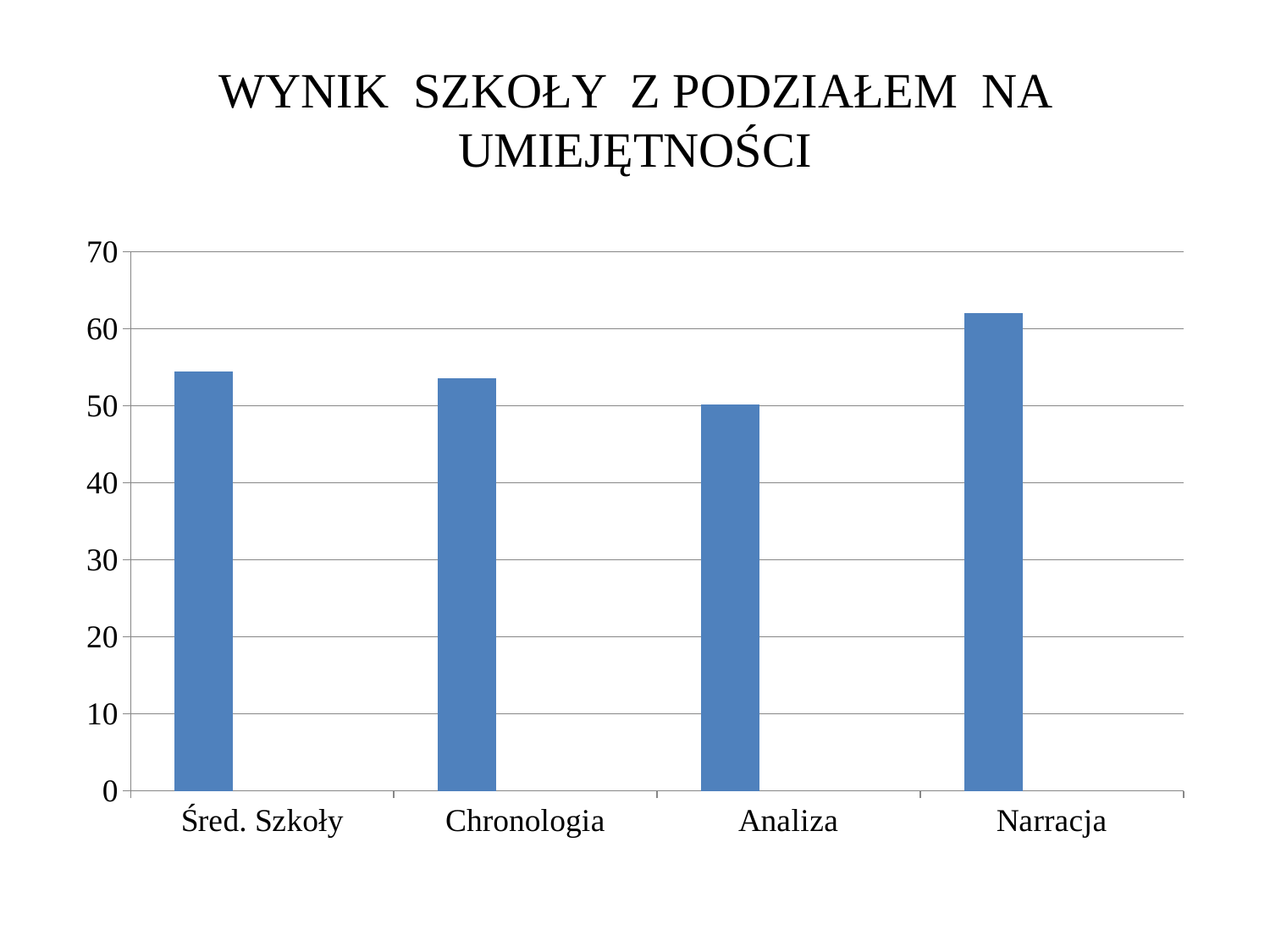
What is the title of the slide above the chart? WYNIK SZKOŁY Z PODZIAŁEM NA UMIEJĘTNOŚCI Which is larger, the value for Narracja or the value for Analiza? Narracja Is the value for Analiza greater or less than 60? less Is the value for Chronologia greater or less than 60? less Is the value for Narracja greater or less than 60? greater What kind of chart is shown on the slide? bar chart Which category has the lowest bar in the chart? Analiza How many categories are shown on the x axis of the chart? 4 Which category has the highest bar in the chart? Narracja Which is larger, the value for Śred. Szkoły or the value for Analiza? Śred. Szkoły